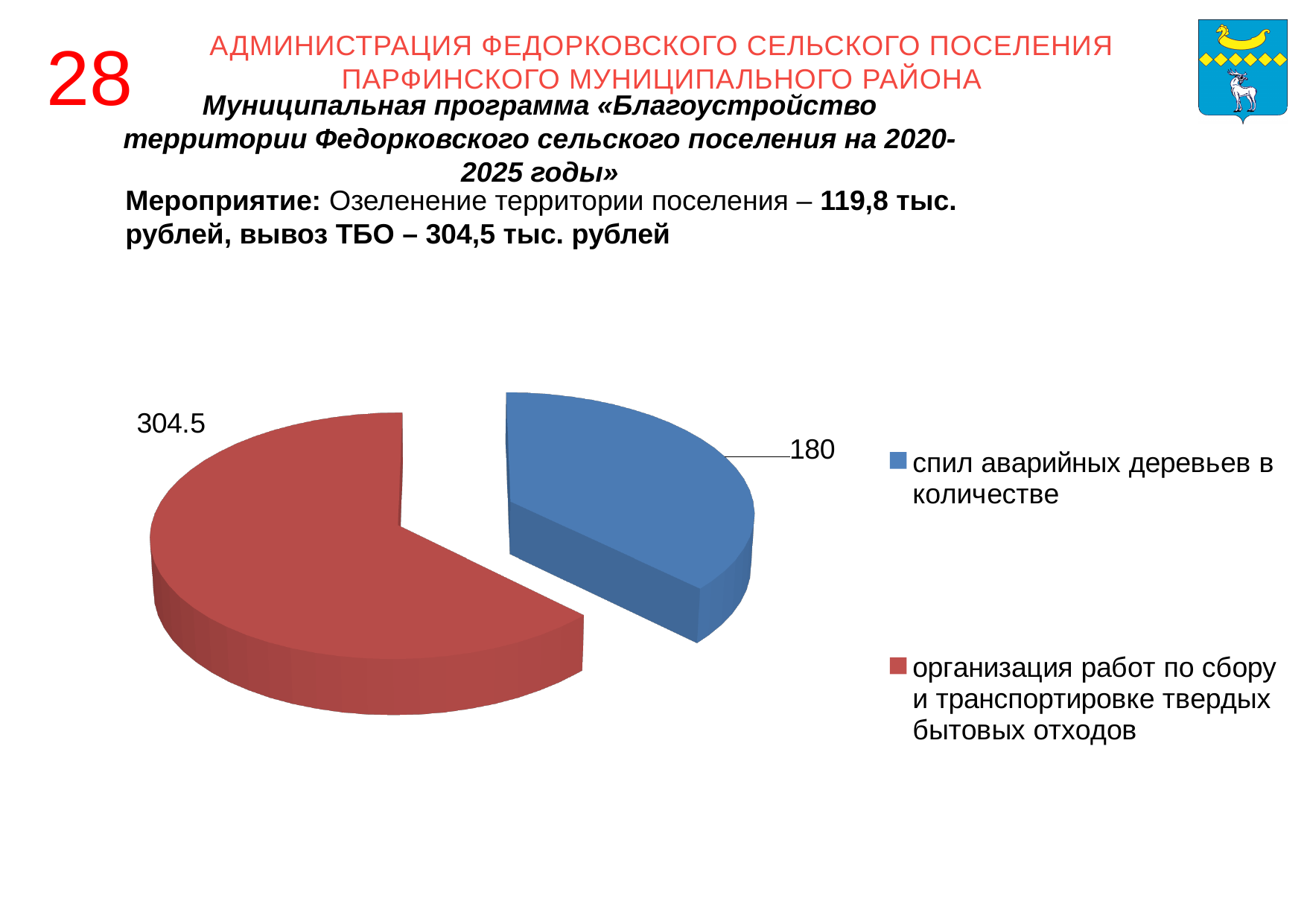
Which slice of the pie chart has the largest value? организация работ по сбору и транспортировке твердых бытовых отходов Which slice of the pie chart has the smallest value? спил аварийных деревьев в количестве How many slices does the pie chart have? 2 Which is larger: the value for "спил аварийных деревьев в количестве" or the value for "организация работ по сбору и транспортировке твердых бытовых отходов"? организация работ по сбору и транспортировке твердых бытовых отходов What colour is the slice for "организация работ по сбору и транспортировке твердых бытовых отходов"? red What is the difference between the value for "организация работ по сбору и транспортировке твердых бытовых отходов" and the value for "спил аварийных деревьев в количестве"? 124.5 What type of chart is shown on the slide? pie chart How many entries does the legend of the pie chart list? 2 What is the value for the slice "организация работ по сбору и транспортировке твердых бытовых отходов"? 304.5 What is the value for the slice "спил аварийных деревьев в количестве"? 180 What is the total of the two values shown on the pie chart? 484.5 What colour is the slice for "спил аварийных деревьев в количестве"? blue